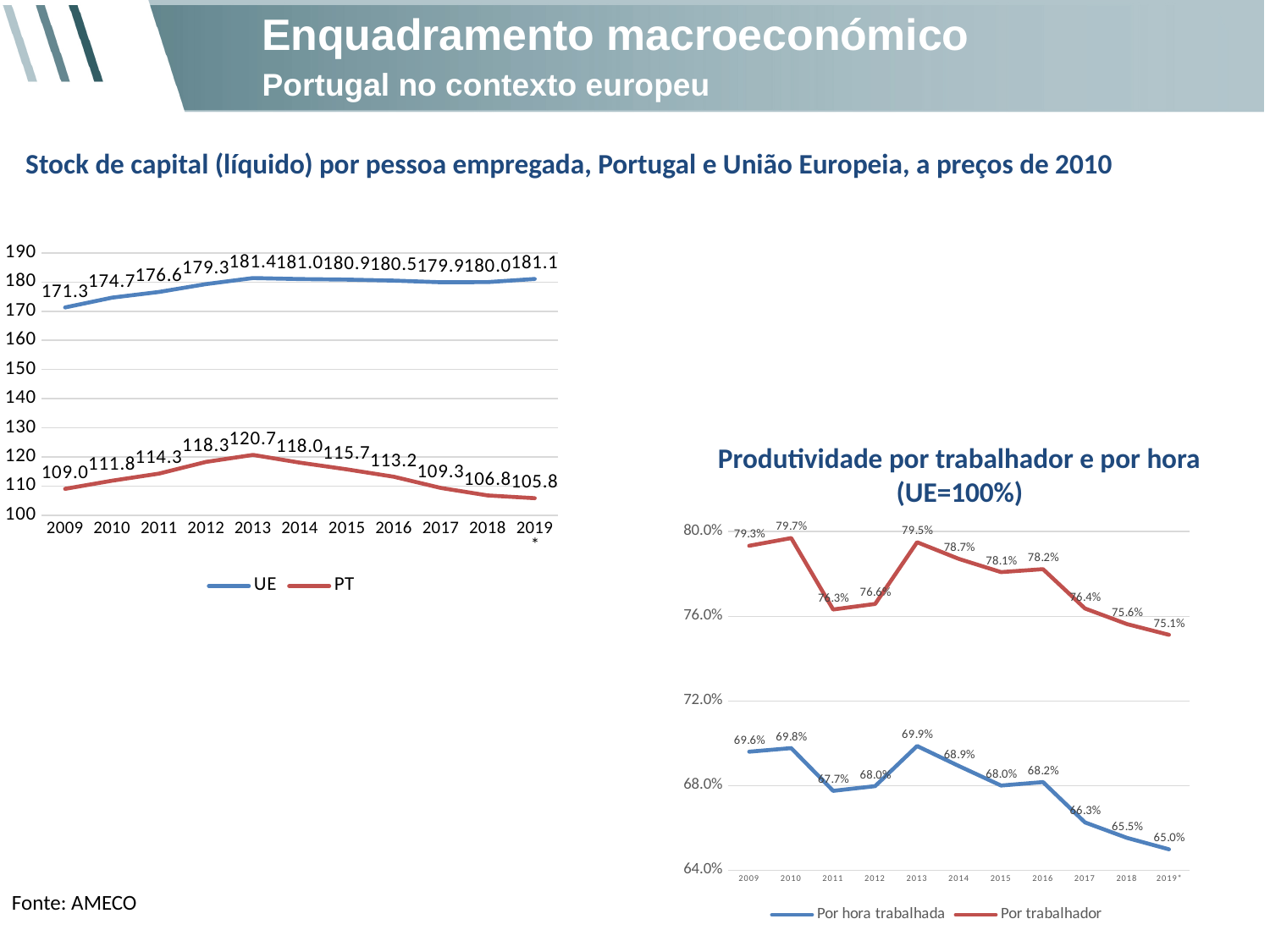
In the left chart (Stock de capital por pessoa empregada), how many series does the legend list? 2 In the left chart (Stock de capital por pessoa empregada), what is the difference between UE and PT in 2019*? 75.3 In the left chart (Stock de capital por pessoa empregada), what is the value for UE in 2009? 171.3 What type of chart is the left chart (Stock de capital por pessoa empregada)? Line chart In the left chart (Stock de capital por pessoa empregada), in which year does the PT series reach its highest value? 2013 In the right chart (Produtividade por trabalhador e por hora), in which year is Por hora trabalhada highest? 2013 In the right chart (Produtividade por trabalhador e por hora), what is the value for Por hora trabalhada in 2019*? 65.0% In the right chart (Produtividade por trabalhador e por hora), what is the value for Por trabalhador in 2010? 79.7% In the left chart (Stock de capital por pessoa empregada), what is the value for PT in 2013? 120.7 In the right chart (Produtividade por trabalhador e por hora), does the Por trabalhador series rise or fall from 2016 to 2019*? Fall In the right chart (Produtividade por trabalhador e por hora), how many years are plotted on the x axis? 11 In the left chart (Stock de capital por pessoa empregada), in which year is the PT series lowest? 2019*